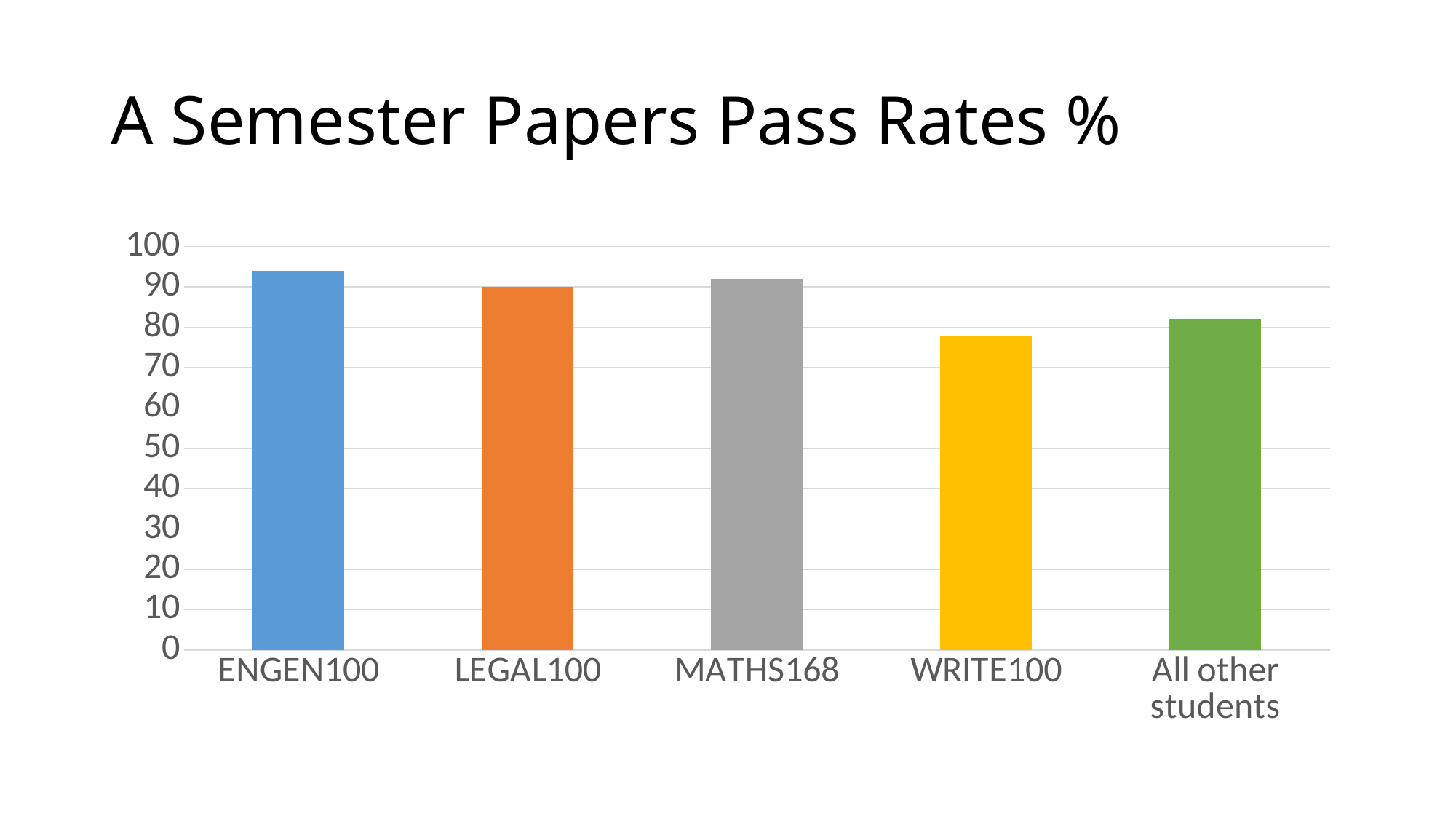
Is the value for All other students greater or less than 80? greater Which has a higher pass rate, MATHS168 or All other students? MATHS168 What kind of chart is shown on the slide? bar chart Which category has the highest pass rate? ENGEN100 Is the value for ENGEN100 greater or less than 90? greater What colour is the bar for WRITE100? yellow Which category has the lowest pass rate? WRITE100 Which has a higher pass rate, ENGEN100 or WRITE100? ENGEN100 Is the value for MATHS168 greater or less than 90? greater What is the title of the chart? A Semester Papers Pass Rates % How many categories are shown on the x axis of the chart? 5